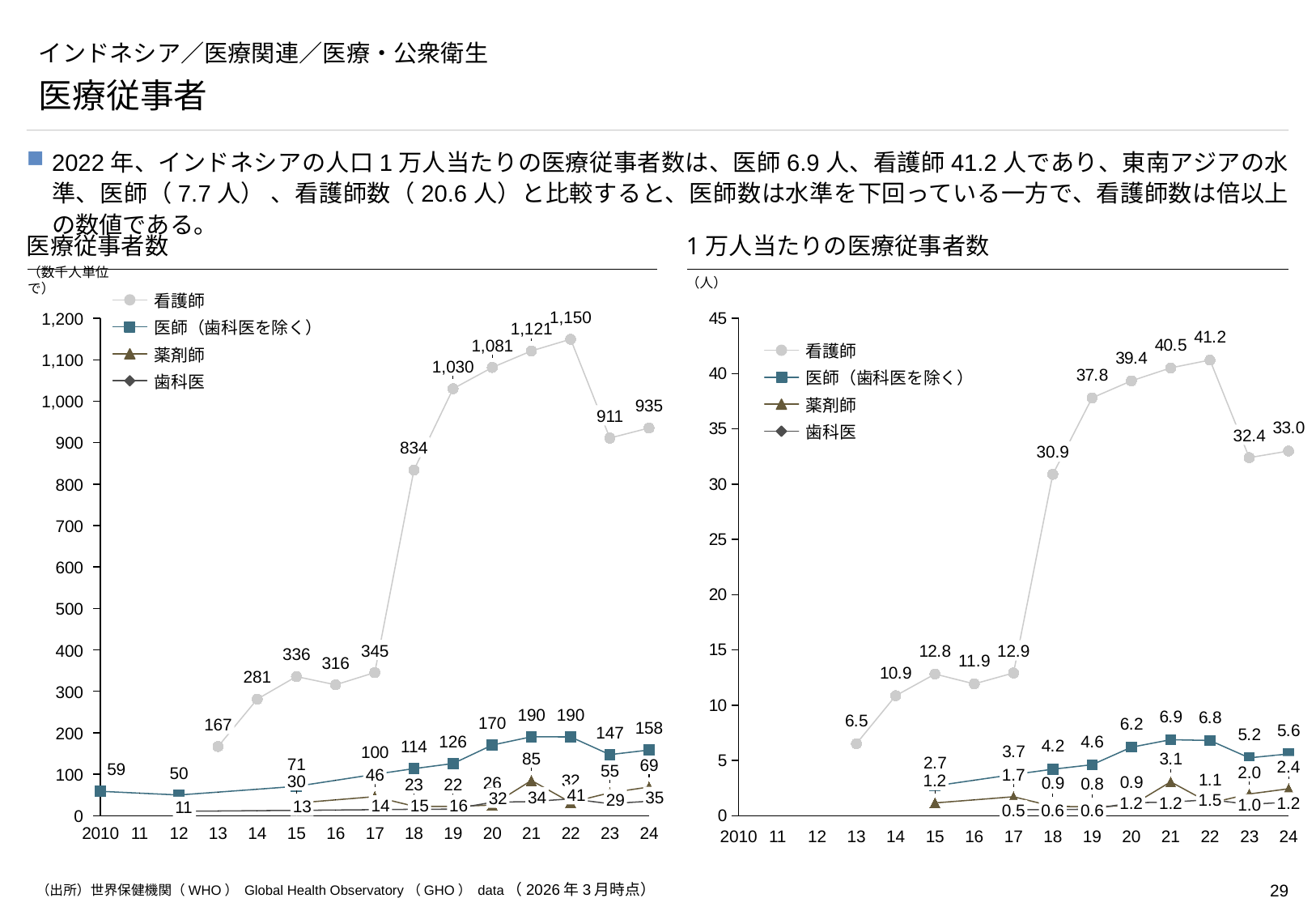
In the left chart (医療従事者数), in which year does the 看護師 series reach its highest value? 2022 In the right chart (1万人当たりの医療従事者数), what is the value for 看護師 in 2022? 41.2 What kind of chart is the left chart (医療従事者数)? Line chart In the right chart (1万人当たりの医療従事者数), what is the difference between the 看護師 values in 2022 and 2023? 8.8 In the left chart (医療従事者数), what is the difference between the 看護師 values in 2018 and 2017? 489 In the right chart (1万人当たりの医療従事者数), does the 看護師 series rise or fall from 2017 to 2018? Rise In the right chart (1万人当たりの医療従事者数), what is the value for 医師（歯科医を除く） in 2021? 6.9 In the left chart (医療従事者数), how many series does the legend list? 4 In the left chart (医療従事者数), what is the value for 医師（歯科医を除く） in 2024? 158 In the right chart (1万人当たりの医療従事者数), which is larger: the 看護師 value in 2023 or in 2024? 2024 In the left chart (医療従事者数), what is the value for 看護師 in 2022? 1,150 In the right chart (1万人当たりの医療従事者数), is the 看護師 value in 2019 greater or less than 35? greater